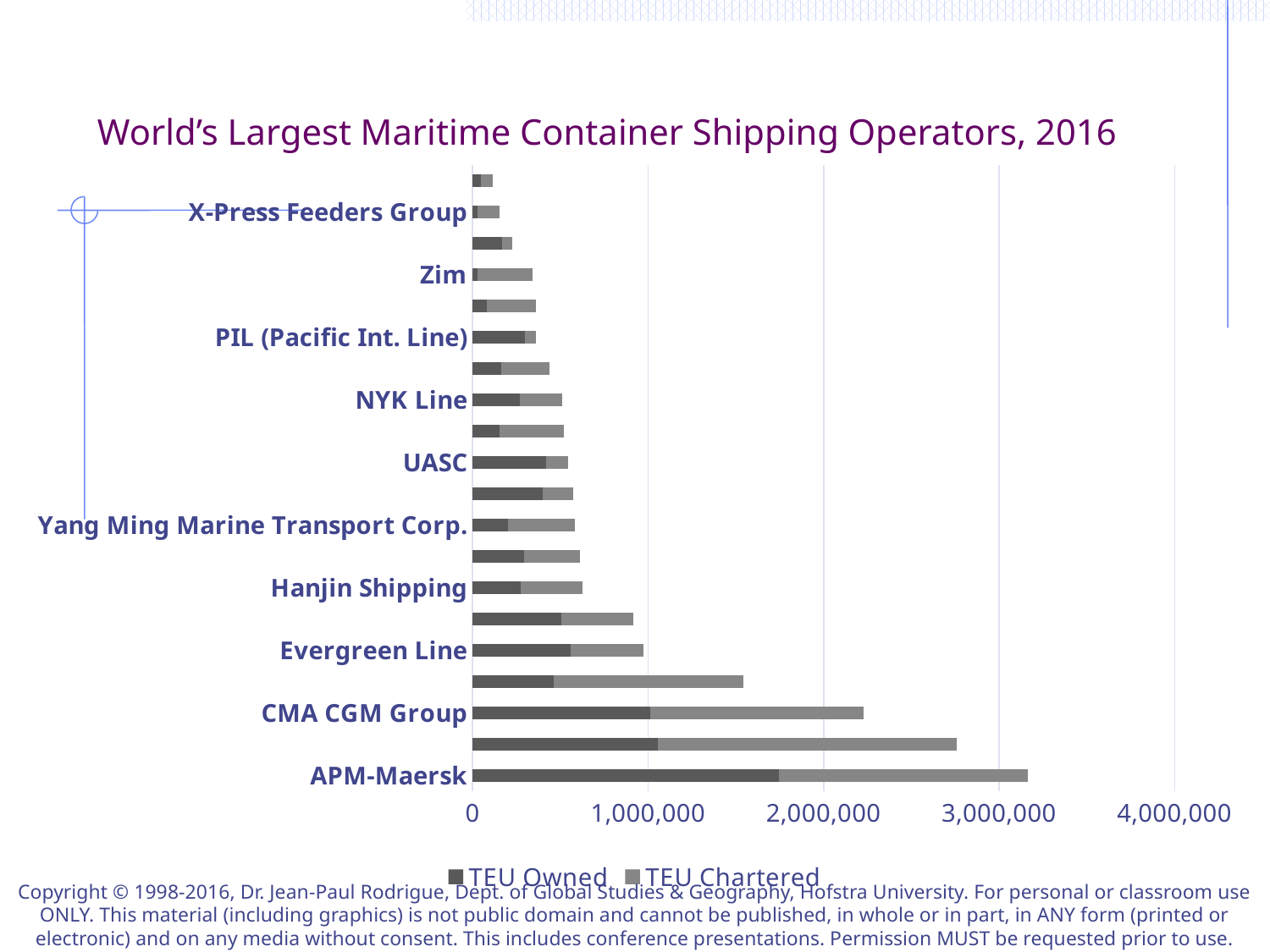
Is the TEU Owned value for APM-Maersk greater or less than 1,000,000? greater Do the total bars get longer or shorter moving from the top of the chart to the bottom? longer Which has the longer total bar, Evergreen Line or Hanjin Shipping? Evergreen Line What kind of chart is shown on the slide? Stacked bar chart Is the total bar for Evergreen Line greater or less than 1,000,000? less What is the title of the chart? World's Largest Maritime Container Shipping Operators, 2016 Is the total bar for CMA CGM Group greater or less than 2,000,000? greater Which labeled operator has the longest total bar? APM-Maersk Which labeled operator has the shortest total bar? X-Press Feeders Group How many series does the legend list? 2 What are the two series named in the legend? TEU Owned and TEU Chartered